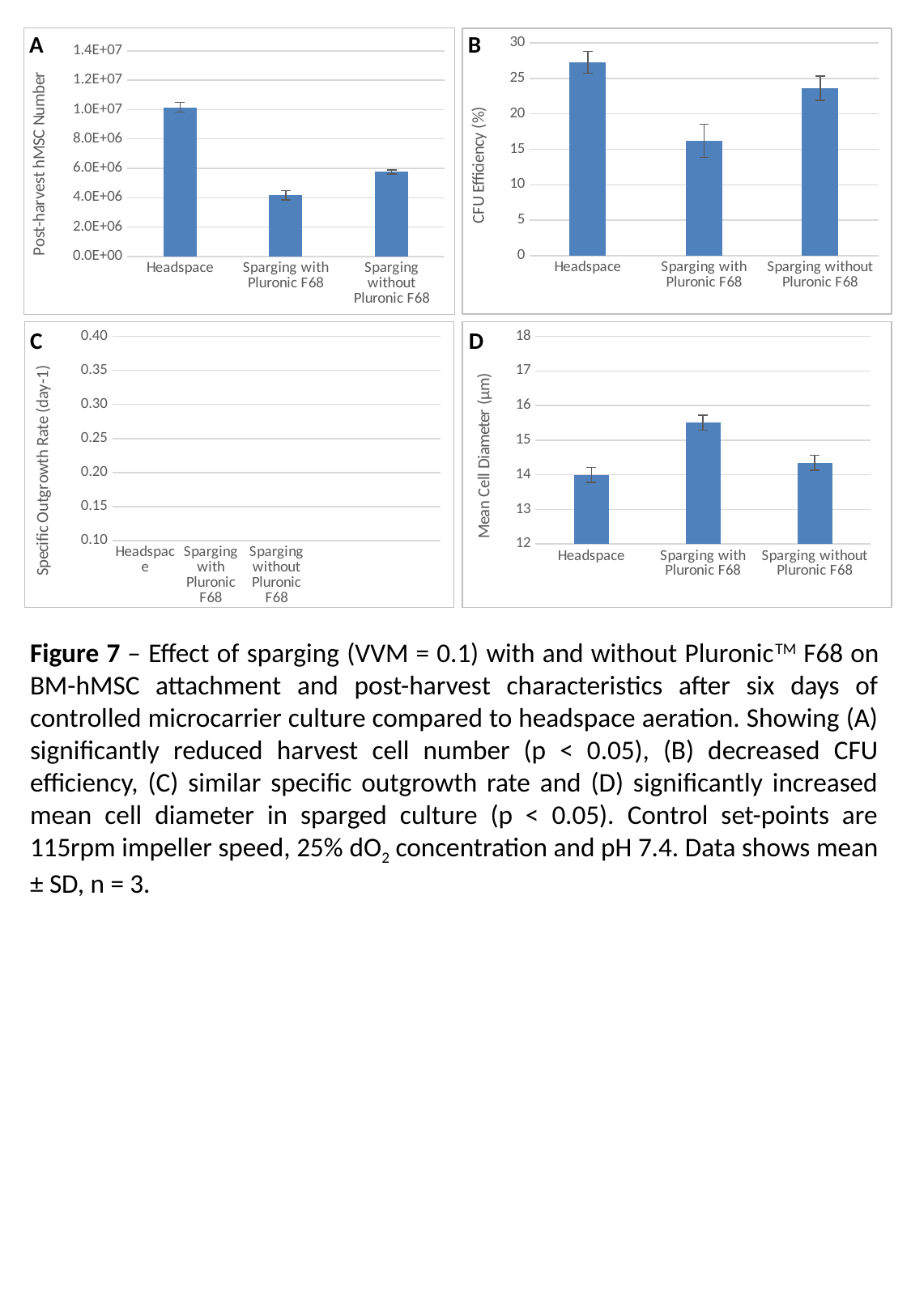
In chart A, is the value for Sparging without Pluronic F68 greater or less than 6.0E+06? less In chart D (Mean Cell Diameter), which condition has the largest mean cell diameter? Sparging with Pluronic F68 In chart B, is the CFU efficiency for Sparging with Pluronic F68 greater or less than 20? less In chart A (Post-harvest hMSC Number), which condition has the highest value? Headspace In chart B (CFU Efficiency), which condition has the lowest CFU efficiency? Sparging with Pluronic F68 How many conditions are shown on the x axis of chart B? 3 In chart A, is the value for Headspace greater or less than 8.0E+06? greater In chart D, which is larger: the mean cell diameter for Headspace or for Sparging with Pluronic F68? Sparging with Pluronic F68 In chart A (Post-harvest hMSC Number), which condition has the lowest value? Sparging with Pluronic F68 What type of chart is chart A? Bar chart